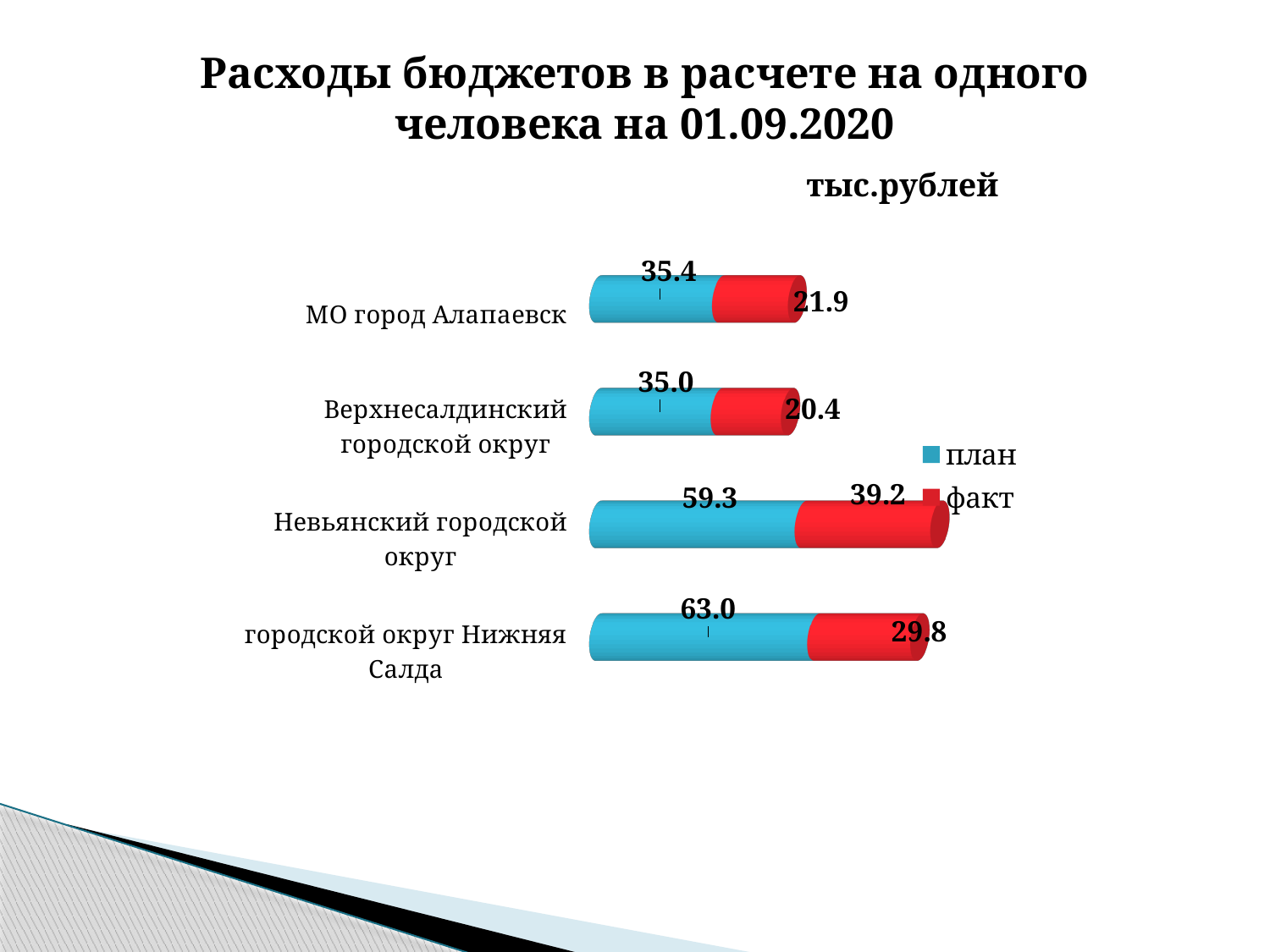
Which category has the lowest факт value? Верхнесалдинский городской округ How many categories are shown in the chart? 4 What is the факт value for Невьянский городской округ? 39.2 Which category has the highest план value? городской округ Нижняя Салда What is the план value for городской округ Нижняя Салда? 63.0 What is the план value for МО город Алапаевск? 35.4 Which is larger, the факт value for Невьянский городской округ or the факт value for городской округ Нижняя Салда? Невьянский городской округ What is the total of the stacked bar for Невьянский городской округ? 98.5 What is the факт value for Верхнесалдинский городской округ? 20.4 What kind of chart is shown on the slide? bar chart How many series does the legend list? 2 What is the difference between the план and факт values for МО город Алапаевск? 13.5